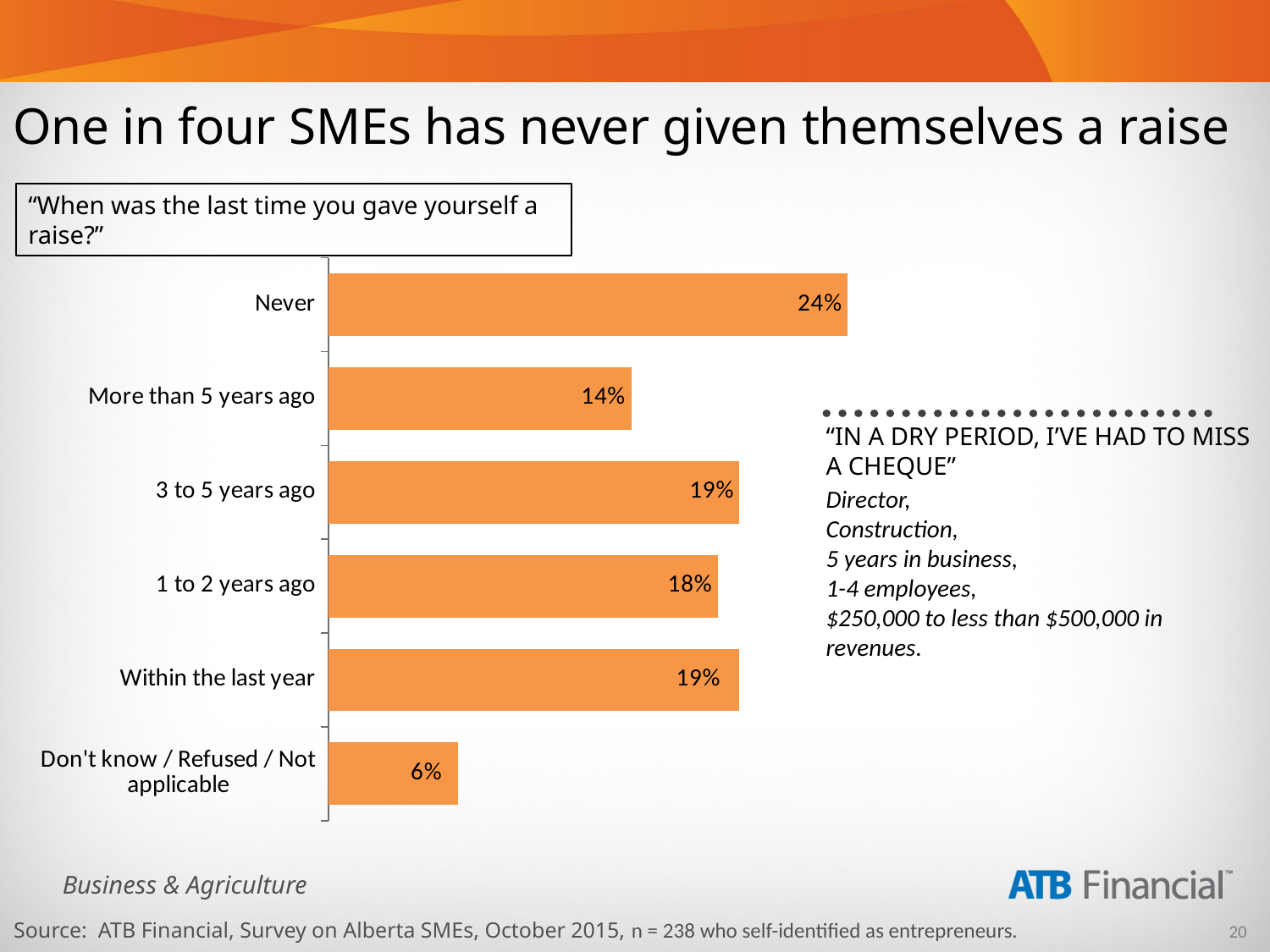
Which is larger, the value for "3 to 5 years ago" or the value for "More than 5 years ago"? 3 to 5 years ago What is the combined value of "Within the last year" and "1 to 2 years ago"? 37% What is the value for "Don't know / Refused / Not applicable"? 6% Which category has the lowest value? Don't know / Refused / Not applicable What survey question does the chart present? "When was the last time you gave yourself a raise?" What percentage of SMEs answered "Never" to when they last gave themselves a raise? 24% Which category has the highest value? Never What is the value for "1 to 2 years ago"? 18% What kind of chart is shown on the slide? Bar chart What is the difference between the values for "Never" and "More than 5 years ago"? 10% How many categories are shown in the chart? 6 What is the value for "More than 5 years ago"? 14%